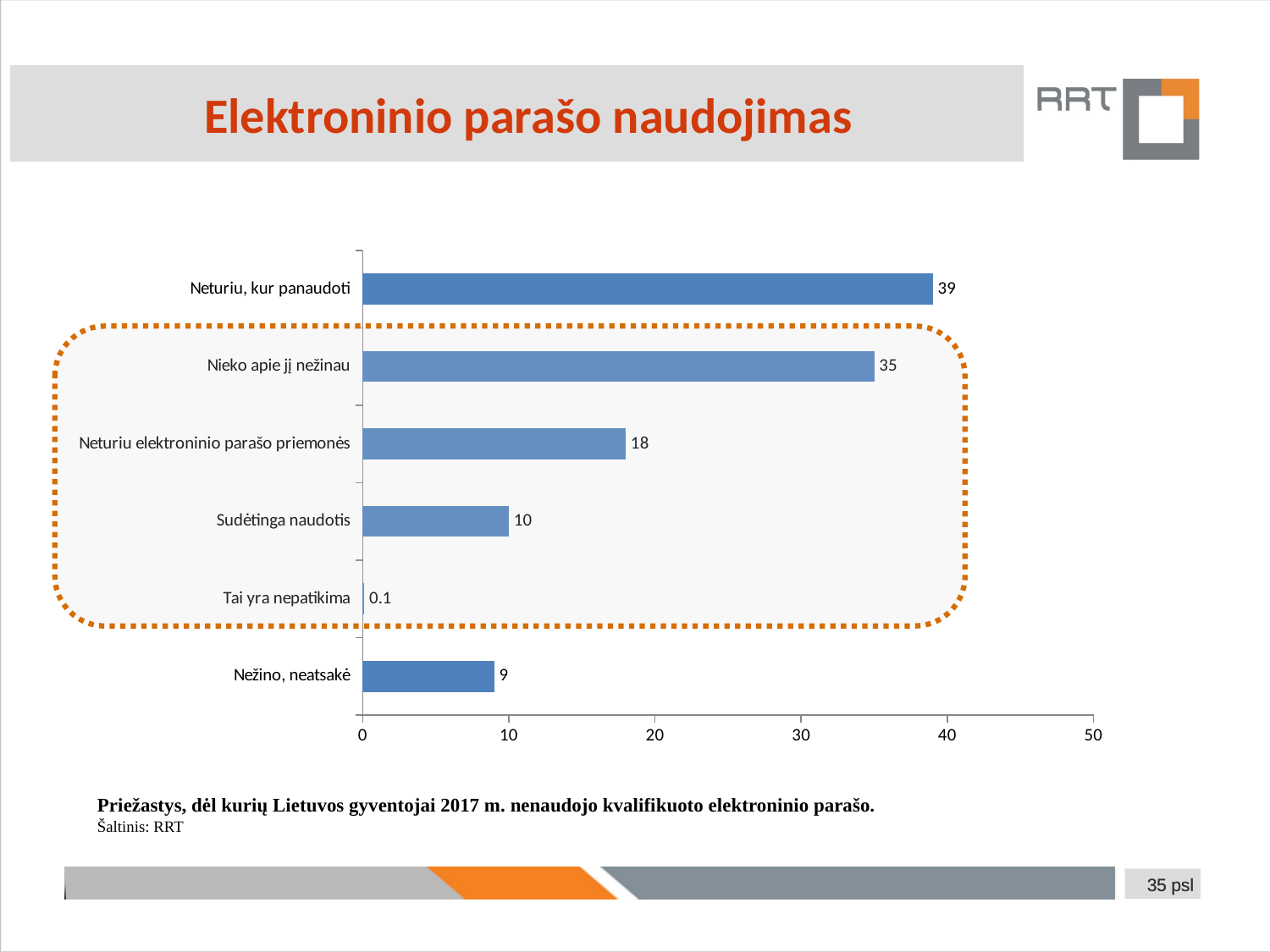
Which category has the highest value? Neturiu, kur panaudoti Which is larger, the value for "Sudėtinga naudotis" or the value for "Nežino, neatsakė"? Sudėtinga naudotis Which category has the lowest value? Tai yra nepatikima What is the value for "Neturiu, kur panaudoti"? 39 What is the difference between the values for "Neturiu, kur panaudoti" and "Nieko apie jį nežinau"? 4 What is the value for "Nieko apie jį nežinau"? 35 What is the highest value shown on the x axis? 50 Is the value for "Neturiu elektroninio parašo priemonės" greater or less than 20? less What is the value for "Neturiu elektroninio parašo priemonės"? 18 What kind of chart is shown on the slide? bar chart What is the value for "Tai yra nepatikima"? 0.1 How many categories are shown in the chart? 6